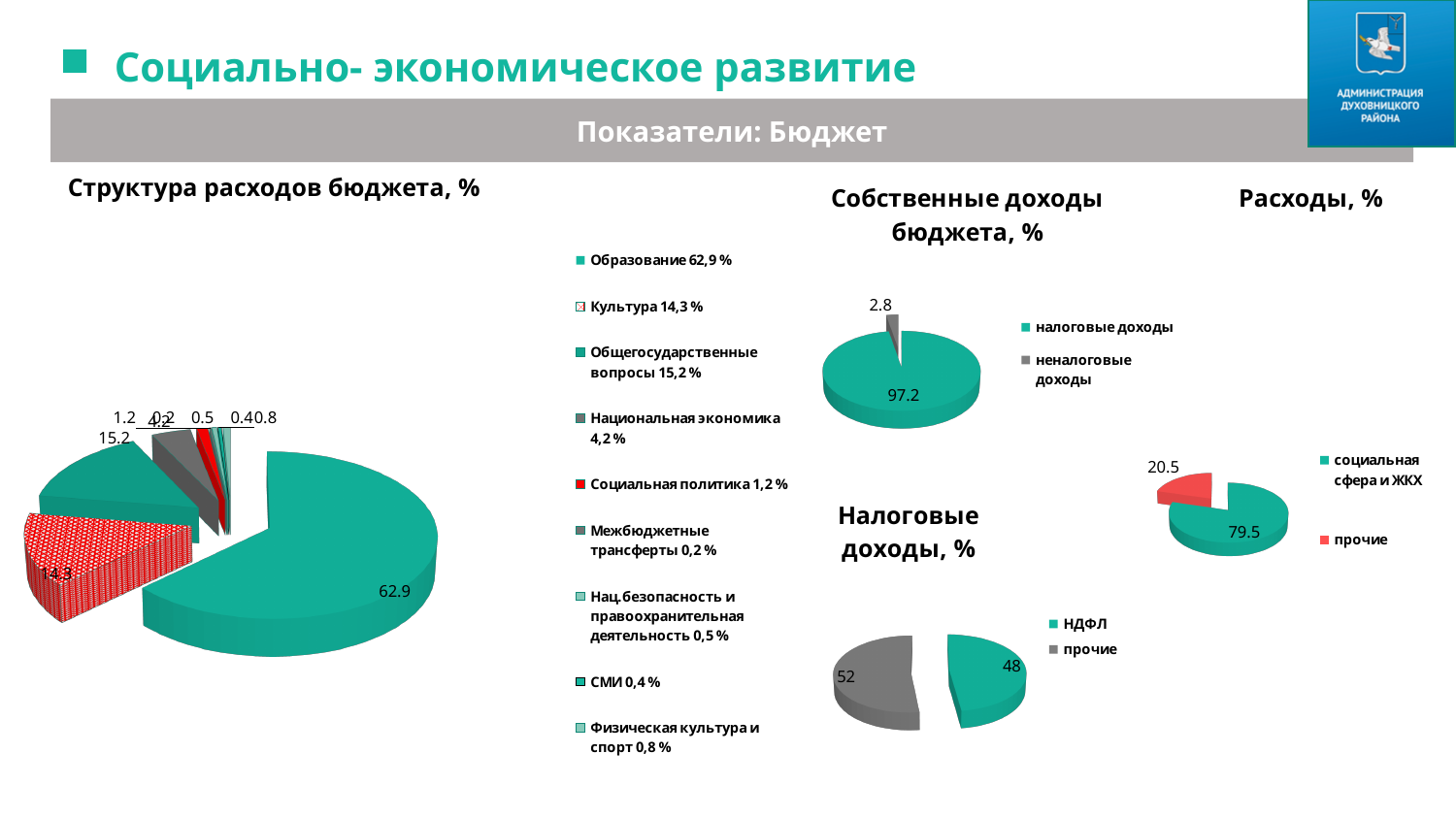
In the chart "Собственные доходы бюджета, %", what is the value for налоговые доходы? 97.2 In the chart "Расходы, %", what is the difference between социальная сфера и ЖКХ (79.5) and прочие (20.5)? 59 In the chart "Структура расходов бюджета, %", what is the value for Образование? 62.9 What kind of chart is "Структура расходов бюджета, %"? pie chart How many categories does the legend of "Структура расходов бюджета, %" list? 9 In the chart "Структура расходов бюджета, %", which category has the largest share? Образование In the chart "Налоговые доходы, %", what is the value for НДФЛ? 48 In the chart "Структура расходов бюджета, %", which is larger: Общегосударственные вопросы or Культура? Общегосударственные вопросы In the chart "Структура расходов бюджета, %", what is the difference between Образование (62.9) and Общегосударственные вопросы (15.2)? 47.7 How many entries does the legend of "Собственные доходы бюджета, %" list? 2 In the chart "Расходы, %", what is the value for прочие? 20.5 In the chart "Налоговые доходы, %", which is larger: НДФЛ or прочие? прочие